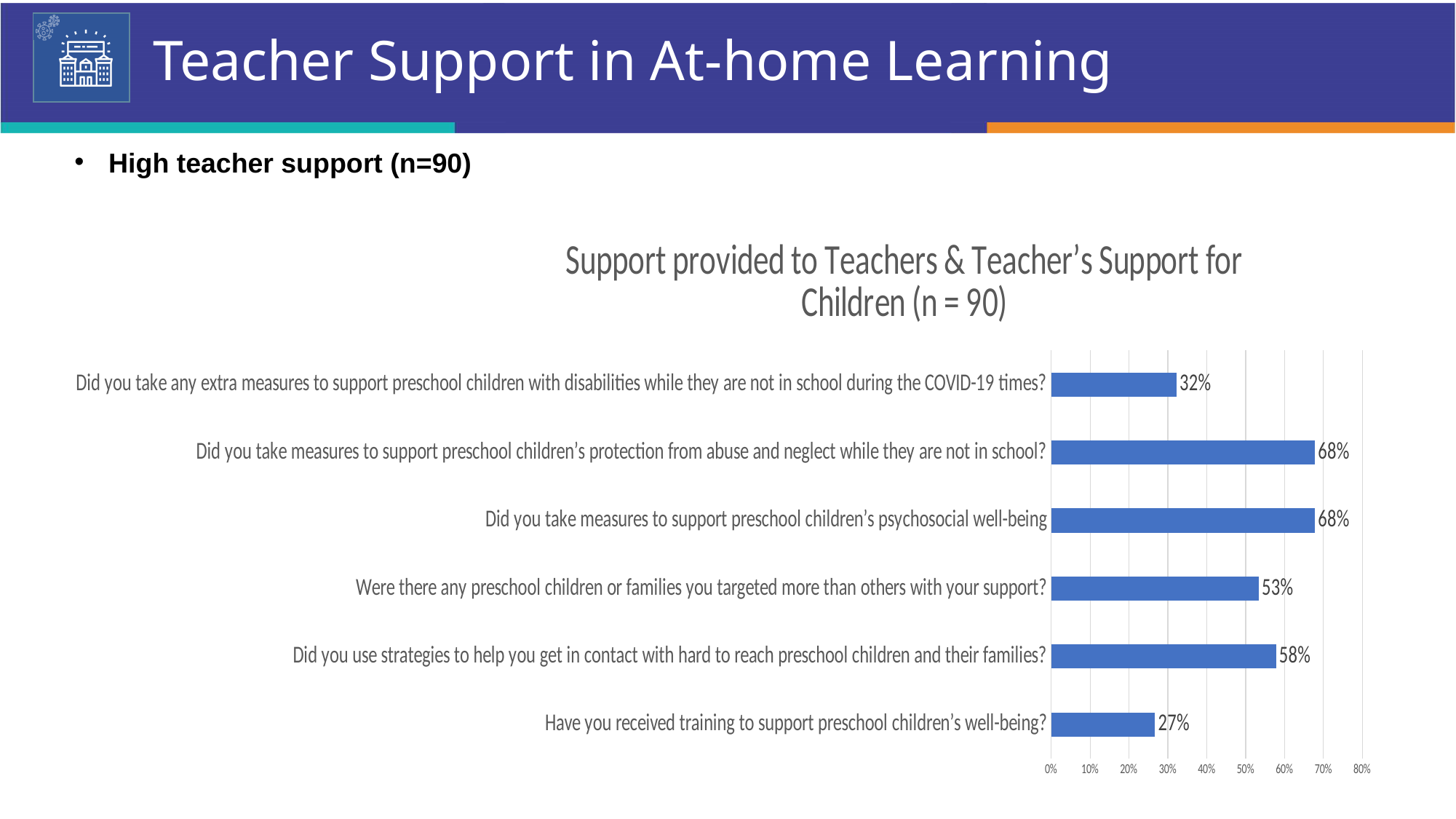
How many questions (categories) are shown in the chart? 6 What percentage of teachers said they received training to support preschool children's well-being? 27% Which question has the lowest percentage in the chart? Have you received training to support preschool children's well-being? Which is larger: the percentage for targeting some children or families more than others, or the percentage for taking extra measures to support children with disabilities? Targeting some children or families more than others What is the title of the chart? Support provided to Teachers & Teacher's Support for Children (n = 90) What percentage of teachers took extra measures to support preschool children with disabilities while they are not in school during the COVID-19 times? 32% What percentage of teachers used strategies to help get in contact with hard to reach preschool children and their families? 58% What type of chart is shown on the slide? Bar chart What percentage of teachers said there were preschool children or families they targeted more than others with their support? 53% What is the highest percentage shown in the chart? 68% What is the difference between the percentage for using strategies to contact hard to reach children and families and the percentage for receiving training to support children's well-being? 31% What is the maximum value shown on the chart's horizontal axis? 80%